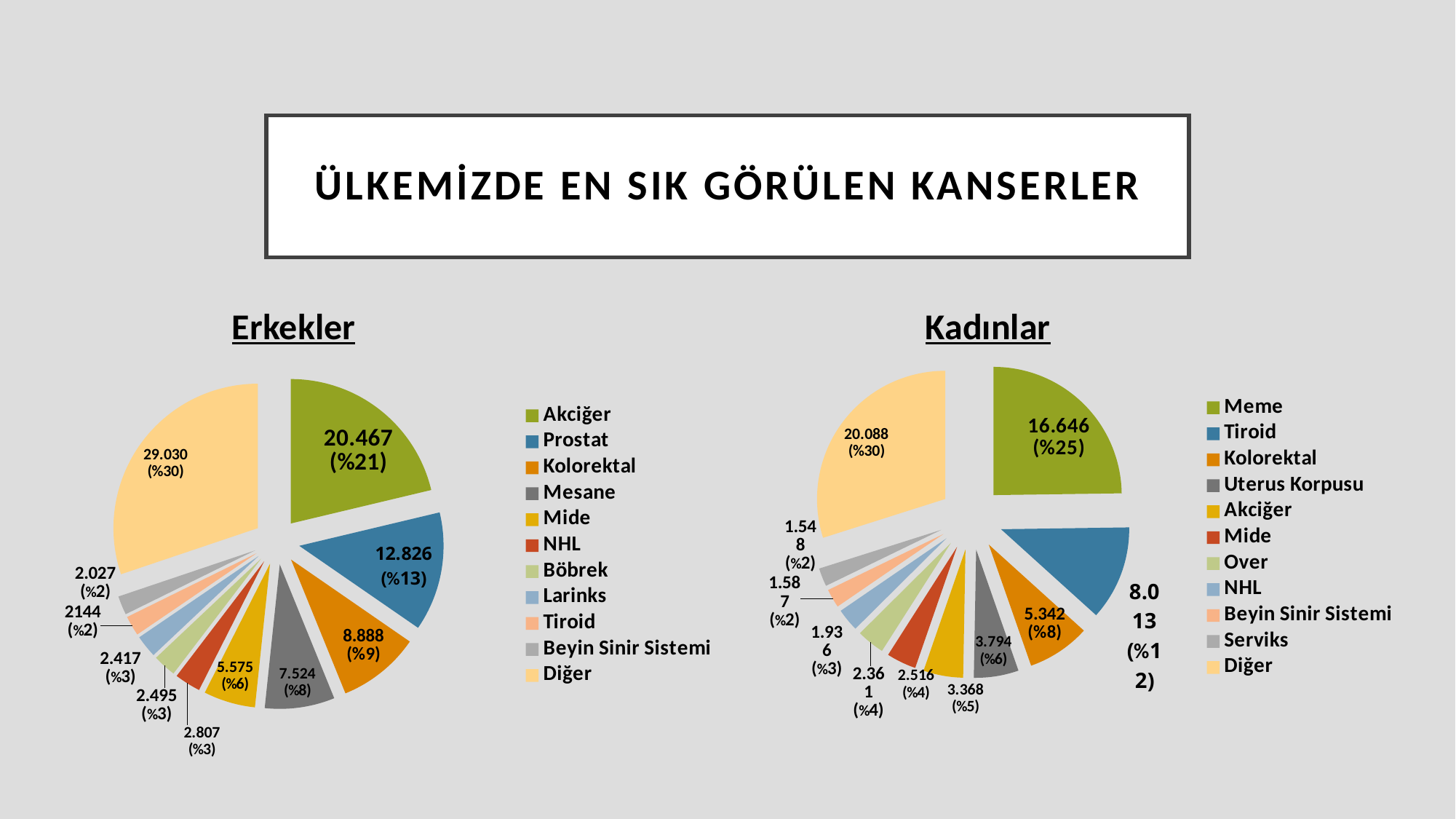
In the Kadınlar pie chart, which slice is larger: Kolorektal or Uterus Korpusu? Kolorektal In the Erkekler pie chart, what percentage share does Prostat have? %13 In the Erkekler pie chart, what is the difference between the Akciğer value and the Prostat value? 7.641 In the Erkekler pie chart, what value is shown for Akciğer? 20.467 (%21) In the Erkekler pie chart, which named cancer type (excluding Diğer) has the largest slice? Akciğer In the Kadınlar pie chart, what percentage share does Diğer have? %30 In the Kadınlar pie chart, what value is shown for Meme? 16.646 (%25) How many entries does the legend of the Kadınlar pie chart list? 11 In the Kadınlar pie chart, which named cancer type (excluding Diğer) has the largest slice? Meme What is the title of the slide? ÜLKEMİZDE EN SIK GÖRÜLEN KANSERLER What type of chart is used for Erkekler and Kadınlar? Pie chart In the Erkekler pie chart, which slice is larger: Kolorektal or Mesane? Kolorektal